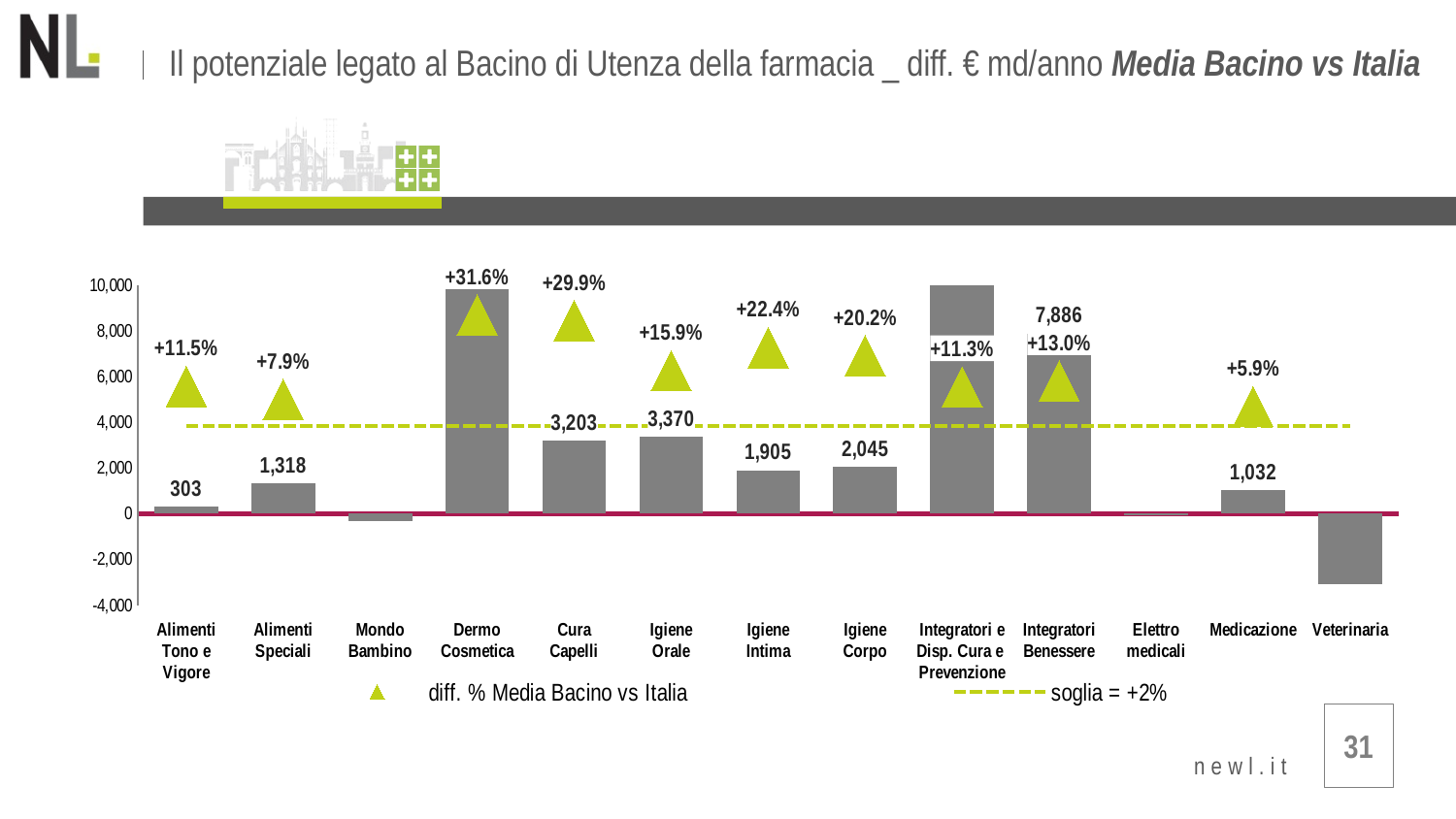
What is the value of the bar for Cura Capelli? 3,203 What is the value of the bar for Integratori Benessere? 7,886 What is the diff. % Media Bacino vs Italia shown for Medicazione? +5.9% Which category has the highest diff. % Media Bacino vs Italia? Dermo Cosmetica What is the difference between the bar values for Igiene Orale and Cura Capelli? 167 Which has the larger bar value, Igiene Corpo or Igiene Intima? Igiene Corpo What is the difference between the bar values for Alimenti Speciali and Alimenti Tono e Vigore? 1,015 How many categories are shown on the x axis? 13 What is the diff. % Media Bacino vs Italia shown for Dermo Cosmetica? +31.6% Is the bar value for Dermo Cosmetica greater or less than 8,000? greater What value is the dashed 'soglia' line set at, according to the legend? +2% Which category has the lowest bar value? Veterinaria